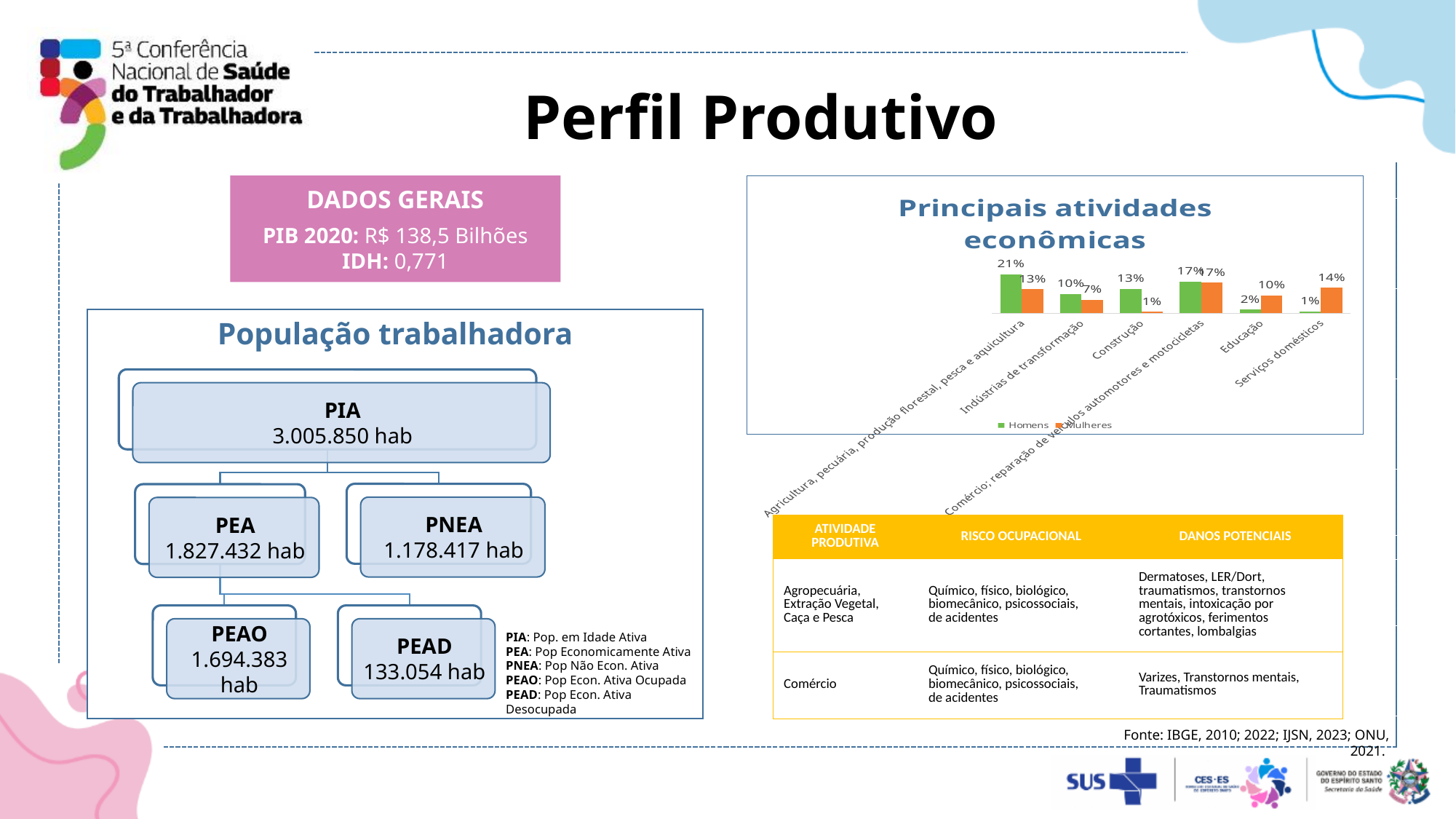
In the "Principais atividades econômicas" chart, which is larger in Educação, Homens or Mulheres? Mulheres In the "Principais atividades econômicas" chart, what is the value for Homens in Construção? 13% What kind of chart is "Principais atividades econômicas"? bar chart In the "Principais atividades econômicas" chart, what is the value for Mulheres in Educação? 10% Which series in the "Principais atividades econômicas" chart is shown in orange? Mulheres In the "Principais atividades econômicas" chart, which category has the lowest value for Mulheres? Construção How many series does the legend of the "Principais atividades econômicas" chart list? 2 How many categories are shown on the x axis of the "Principais atividades econômicas" chart? 6 In the "Principais atividades econômicas" chart, what is the value for Mulheres in Serviços domésticos? 14% In the "Principais atividades econômicas" chart, which category has the highest value for Homens? Agricultura, pecuária, produção florestal, pesca e aquicultura In the "Principais atividades econômicas" chart, what is the value for Homens in Serviços domésticos? 1% In the "Principais atividades econômicas" chart, what is the difference between Homens and Mulheres in Indústrias de transformação? 3%